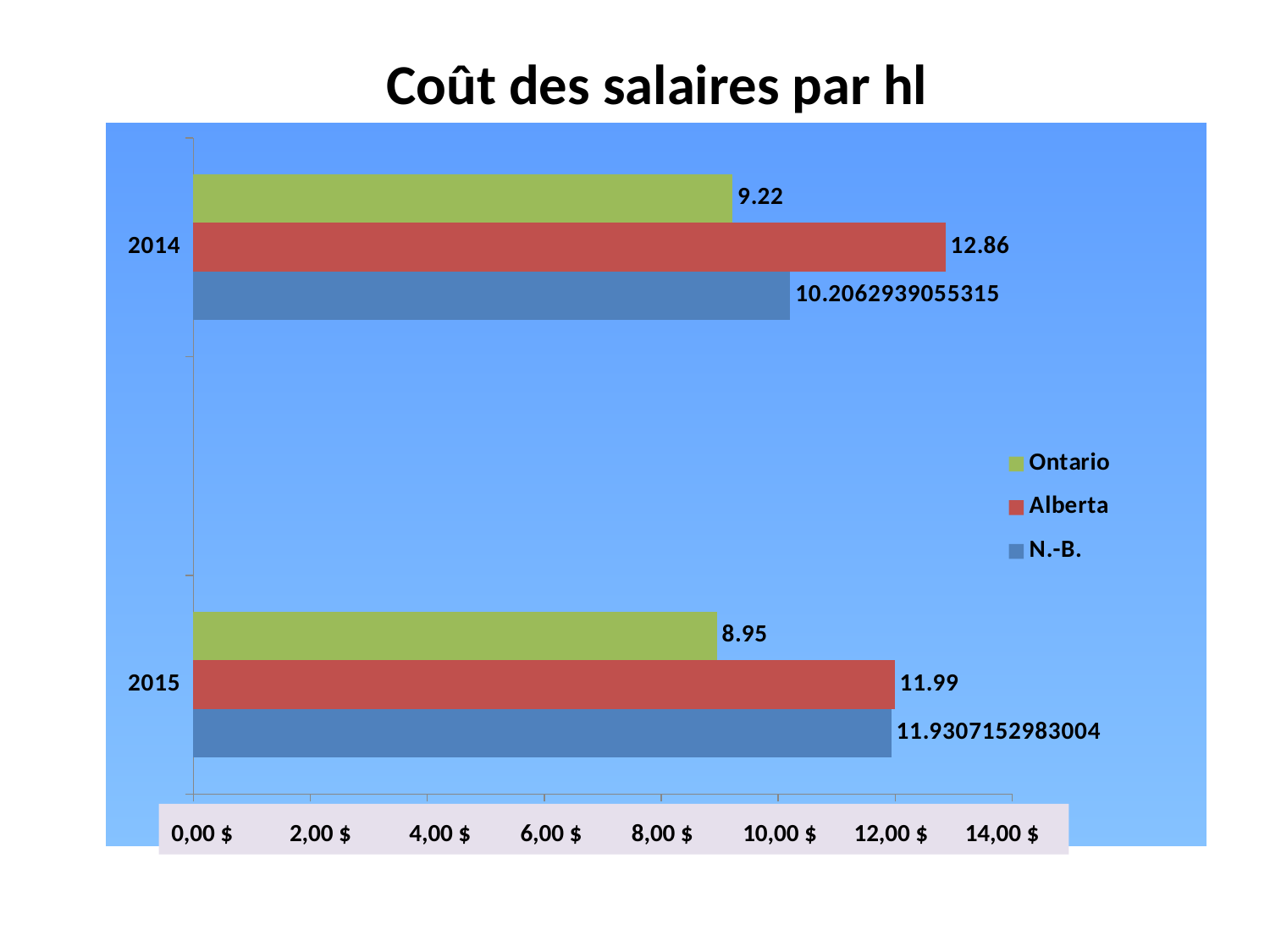
What is the title of the chart? Coût des salaires par hl Which series has the highest value in 2014? Alberta Which is larger, the Ontario value in 2014 or the Ontario value in 2015? 2014 What is the difference between the Alberta values for 2014 and 2015? 0.87 How many series does the legend list? 3 What is the value for N.-B. in 2014? 10.2062939055315 What is the difference between the Alberta and Ontario values in 2014? 3.64 What is the value for Ontario in 2014? 9.22 What is the value for Ontario in 2015? 8.95 What kind of chart is shown? Bar chart Which series has the lowest value in 2015? Ontario What is the value for Alberta in 2015? 11.99